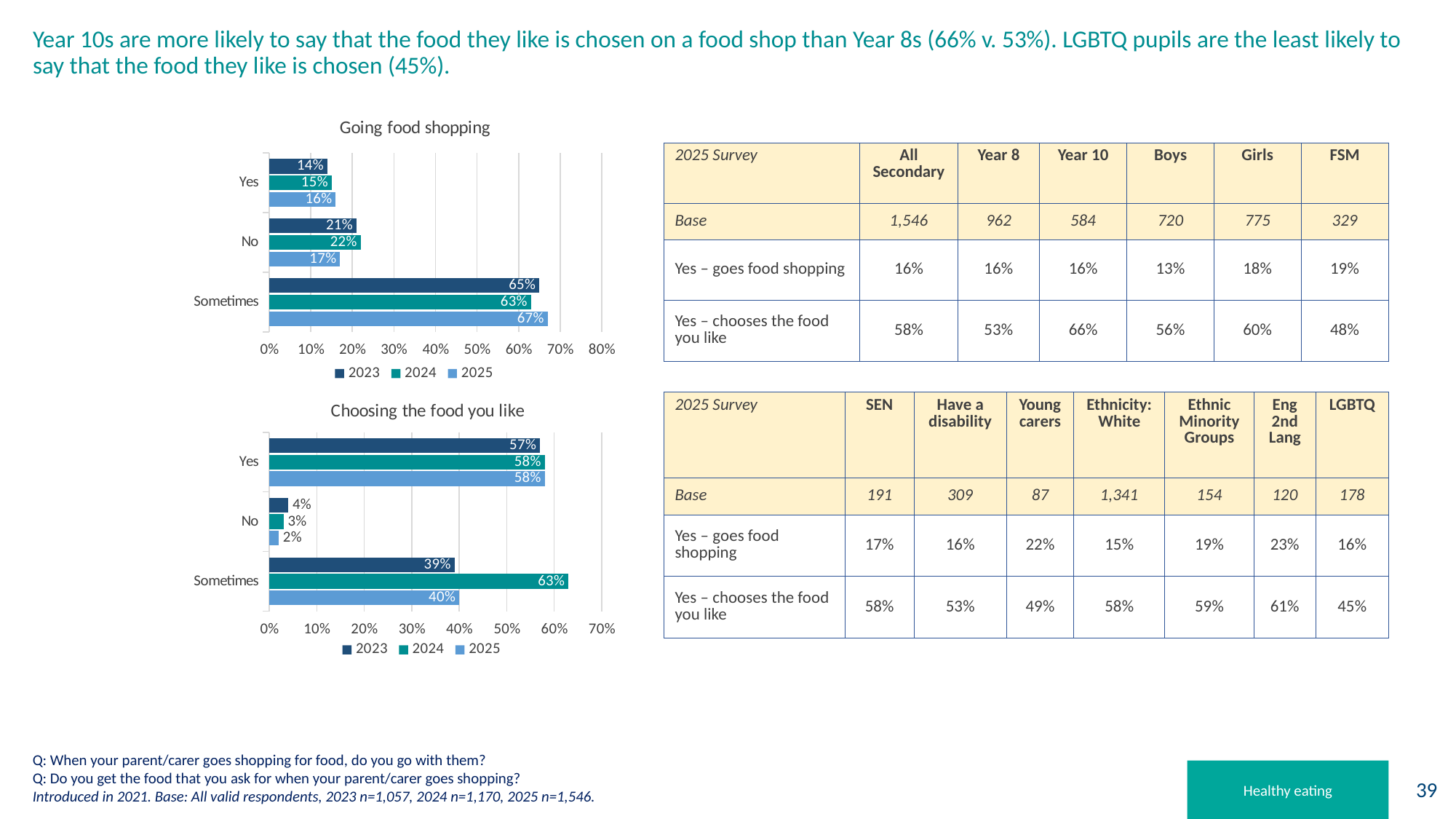
In the 'Going food shopping' chart, what is the 2023 value for No? 21% In the 'Going food shopping' chart, what is the 2025 value for Sometimes? 67% In the 'Going food shopping' chart, what is the difference between the 2025 values for Sometimes and Yes? 51% In the 'Choosing the food you like' chart, what is the 2025 value for No? 2% How many categories are shown on the 'Choosing the food you like' chart? 3 In the 'Going food shopping' chart, which category has the highest 2024 value? Sometimes In the 'Choosing the food you like' chart, which category has the lowest 2023 value? No In the 'Choosing the food you like' chart, what is the 2024 value for Sometimes? 63% How many series does the legend of the 'Going food shopping' chart list? 3 What kind of chart is the 'Going food shopping' chart? Bar chart In the 'Choosing the food you like' chart, what is the difference between the 2024 and 2025 values for Sometimes? 23% In the 'Going food shopping' chart, which is larger: the 2023 value for Yes or the 2023 value for No? No